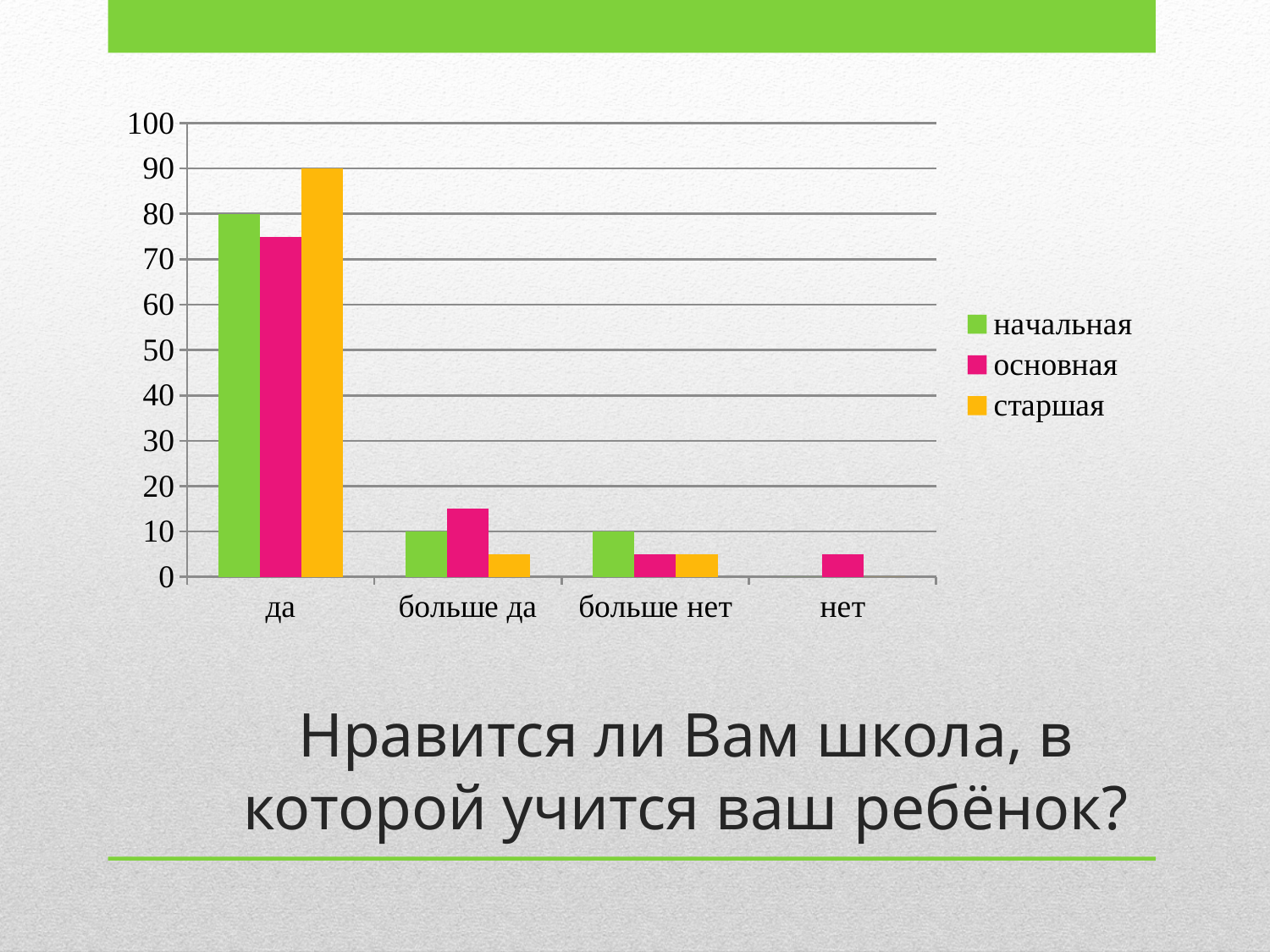
What kind of chart is shown on the slide? bar chart Which series has the lowest value in the category да? основная Which colour represents the series старшая in the legend? yellow How many series does the legend list? 3 What is the value for начальная in the category больше да? 10 How many categories are shown on the x axis? 4 What is the value for старшая in the category да? 90 What is the value for начальная in the category да? 80 Which series has the highest value in the category да? старшая Is the value for основная in the category больше да greater or less than 10? greater What is the difference between the старшая and начальная values in the category да? 10 Is the value for основная in the category да greater or less than 70? greater